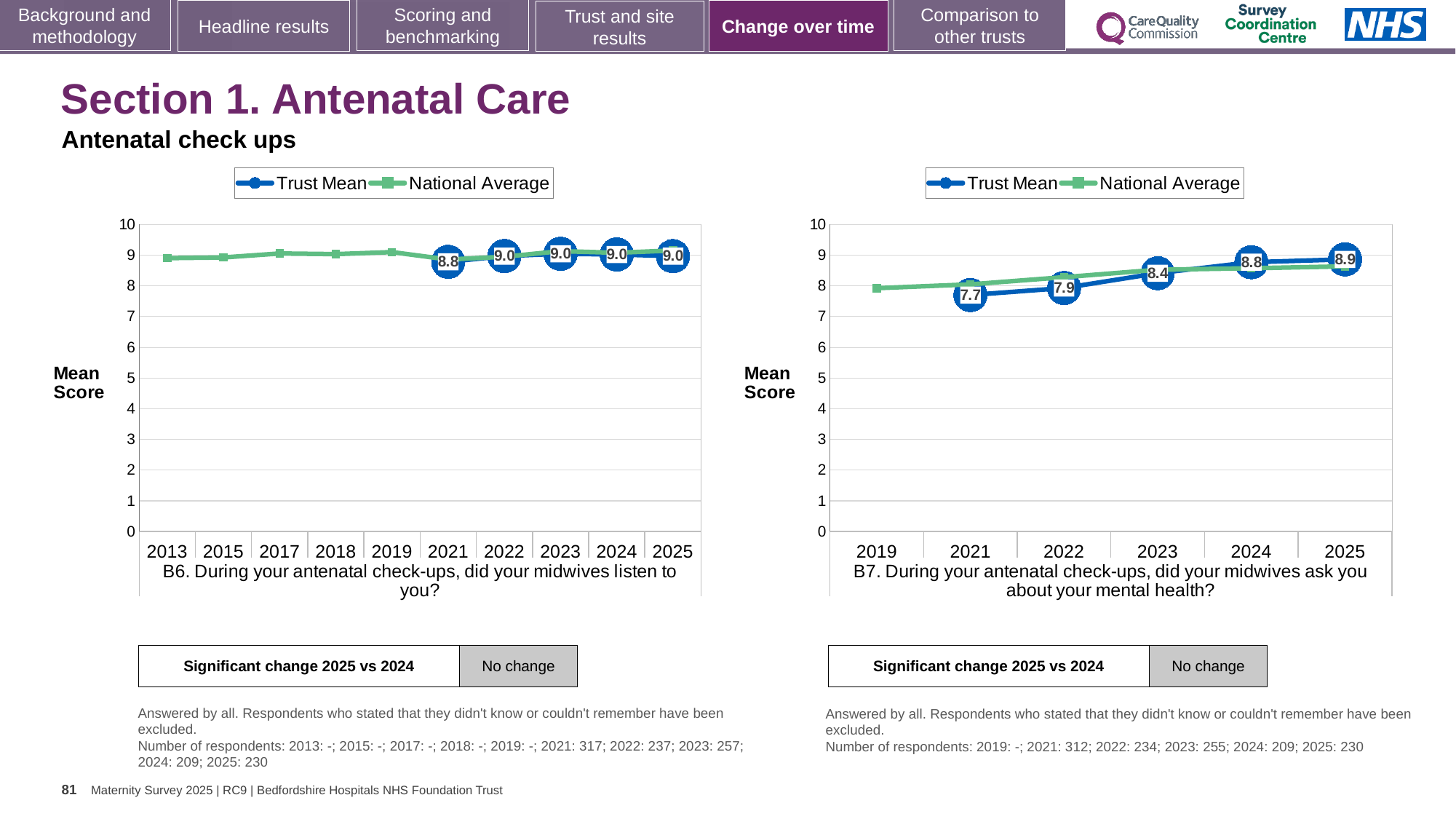
In the B7 chart (right), what is the Trust Mean for 2021? 7.7 In the B7 chart (right), what is the Trust Mean for 2023? 8.4 In the B6 chart (left), is the Trust Mean for 2022 larger or smaller than the Trust Mean for 2021? larger In the B6 chart (left), what is the Trust Mean for 2025? 9.0 In the B6 chart (left), what is the Trust Mean for 2021? 8.8 How many years are shown on the x axis of the B6 chart (left)? 10 In the B7 chart (right), which year has the lowest Trust Mean? 2021 In the B7 chart (right), does the Trust Mean rise or fall from 2021 to 2025? rise How many series does the legend of the B7 chart (right) list? 2 In the B7 chart (right), is the National Average for 2019 greater or less than 7? greater In the B7 chart (right), which year has the highest Trust Mean? 2025 In the B7 chart (right), what is the difference between the Trust Mean for 2025 and the Trust Mean for 2021? 1.2